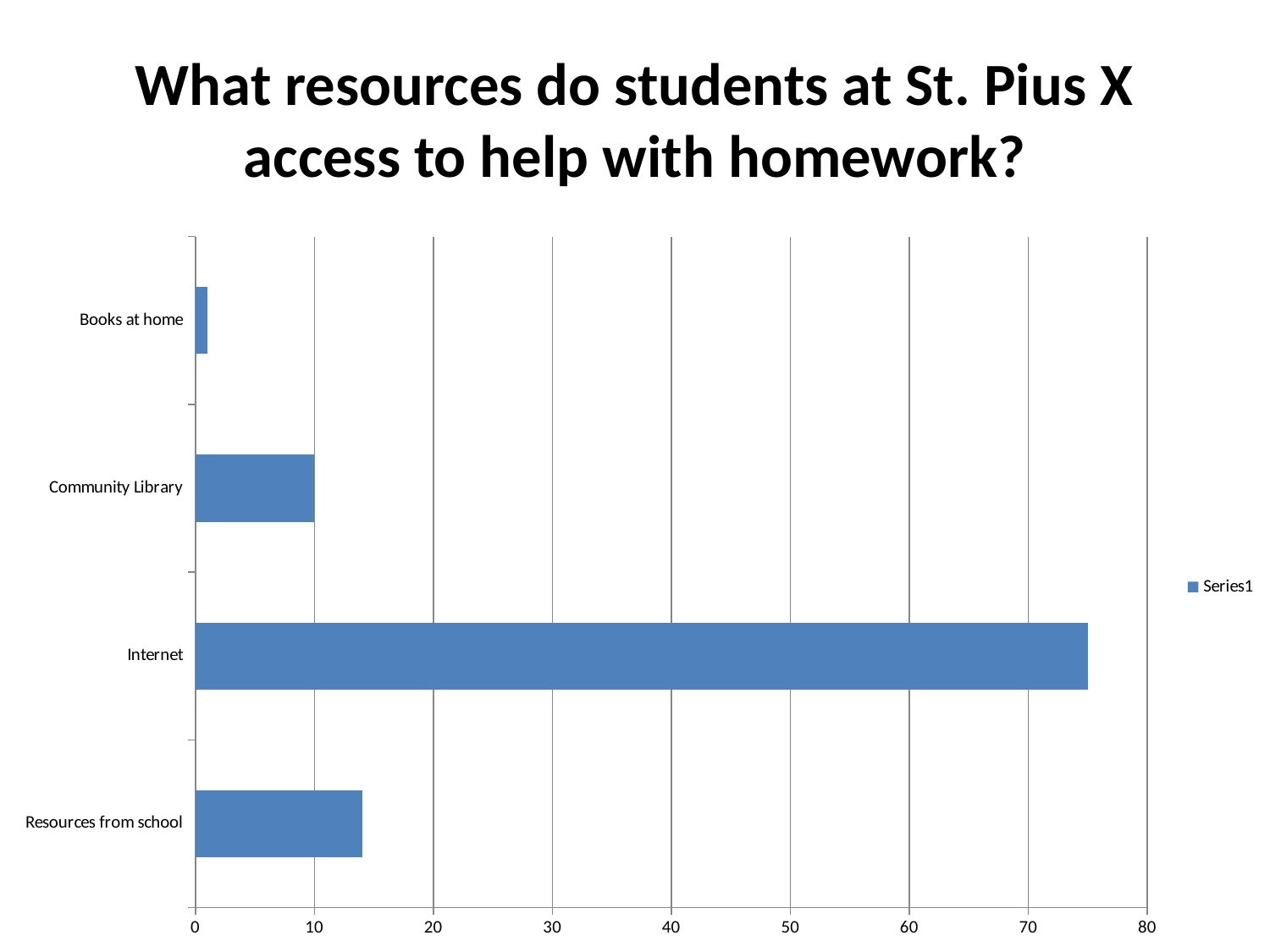
Is the value for Books at home greater or less than 10? less How many categories are shown on the chart? 4 What is the name of the series shown in the legend? Series1 What kind of chart is shown on the slide? bar chart How many series does the legend list? 1 Is the value for Resources from school greater or less than 10? greater Which category has the highest value? Internet What is the title of the chart? What resources do students at St. Pius X access to help with homework? Which category has the lowest value? Books at home Which is larger, the value for Resources from school or the value for Community Library? Resources from school Is the value for Internet greater or less than 70? greater What is the value for Community Library? 10